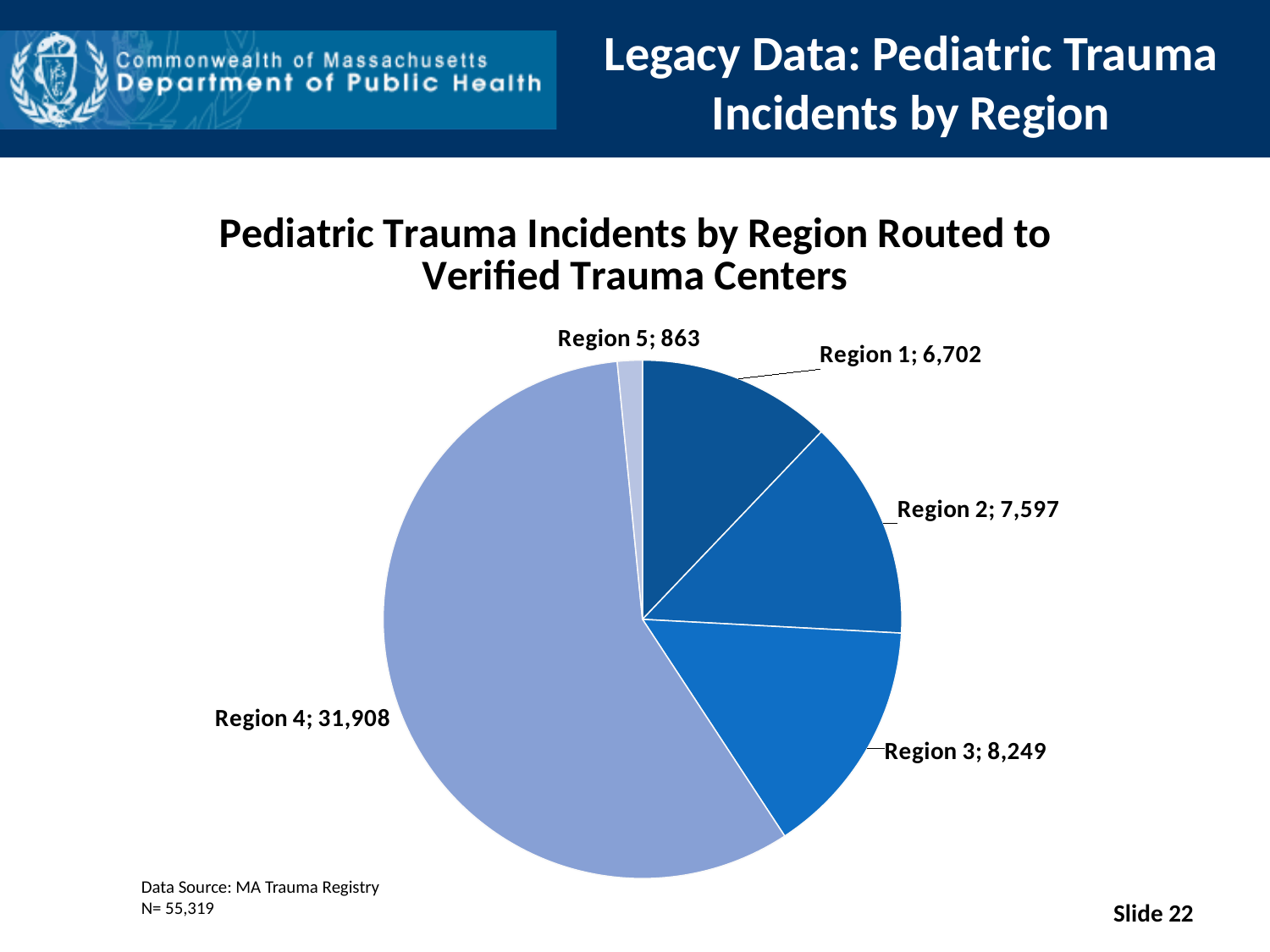
Which has more incidents, Region 1 or Region 3? Region 3 Which region has the largest number of pediatric trauma incidents? Region 4 How many pediatric trauma incidents are shown for Region 4? 31,908 What type of chart is shown on the slide? Pie chart Which region has the smallest number of pediatric trauma incidents? Region 5 What is the value shown for Region 2? 7,597 What is the difference between the values for Region 4 and Region 1? 25,206 How many regions (slices) are shown in the pie chart? 5 What is the total number of incidents across all five regions? 55,319 What is the value shown for Region 5? 863 What is the difference between the values for Region 3 and Region 2? 652 What is the title of the pie chart? Pediatric Trauma Incidents by Region Routed to Verified Trauma Centers